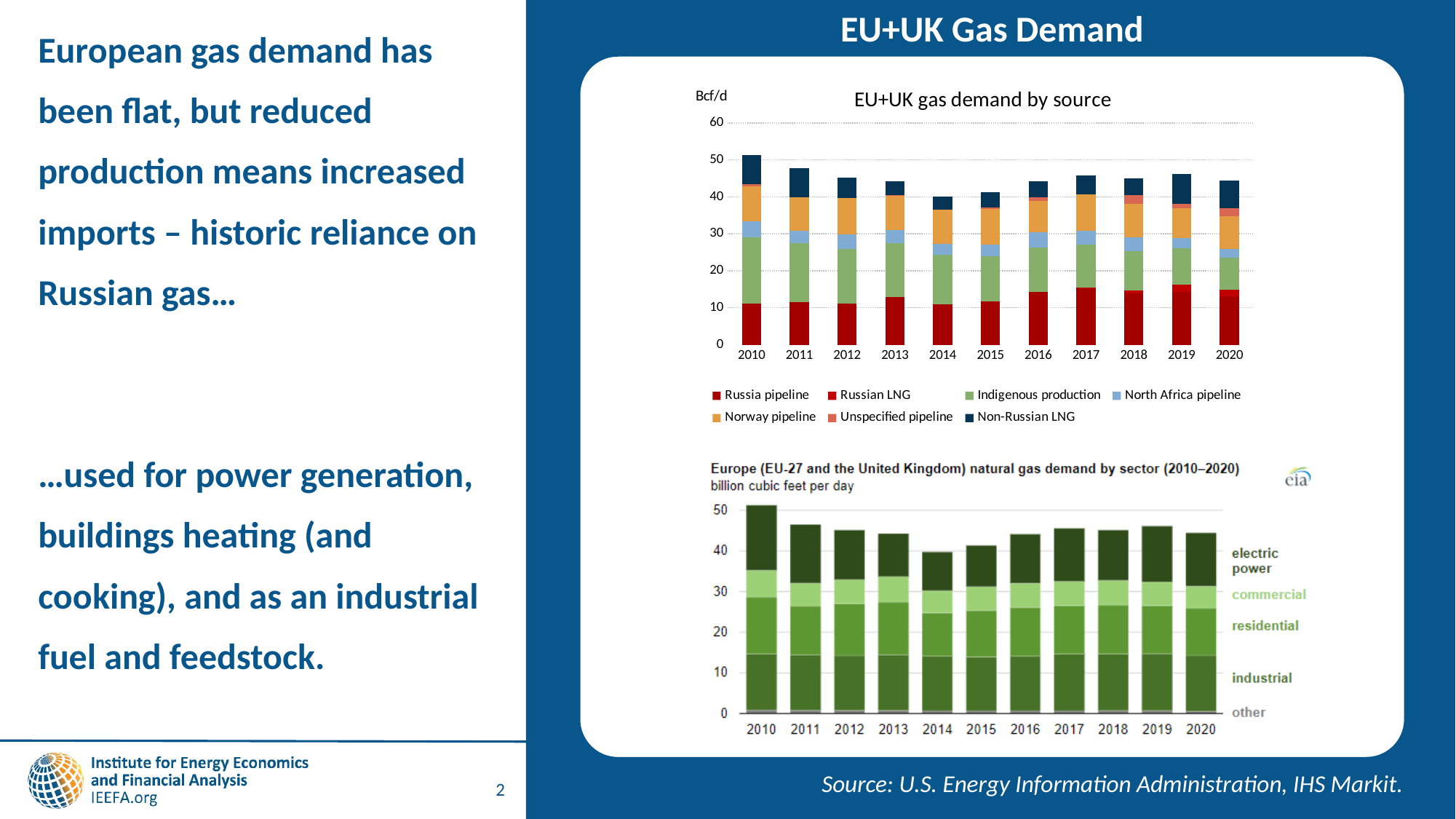
In the top chart "EU+UK gas demand by source", is the total for 2010 greater or less than 40? greater In the top chart "EU+UK gas demand by source", what unit is shown on the y axis? Bcf/d In the bottom chart of natural gas demand by sector, which sector is shown at the top of each stacked bar? electric power In the top chart "EU+UK gas demand by source", how many years are shown on the x axis? 11 In the top chart "EU+UK gas demand by source", is the total for 2014 greater or less than 50? less In the top chart "EU+UK gas demand by source", how many series does the legend list? 7 In the bottom chart of natural gas demand by sector, which year has the highest total demand? 2010 In the top chart "EU+UK gas demand by source", which year has the lowest total gas demand? 2014 In the bottom chart of natural gas demand by sector, is the total for 2014 greater or less than 50? less In the top chart "EU+UK gas demand by source", which year has the highest total gas demand? 2010 What kind of chart is the top chart titled "EU+UK gas demand by source"? Stacked bar chart In the bottom chart of natural gas demand by sector, how many sectors are labelled? 5